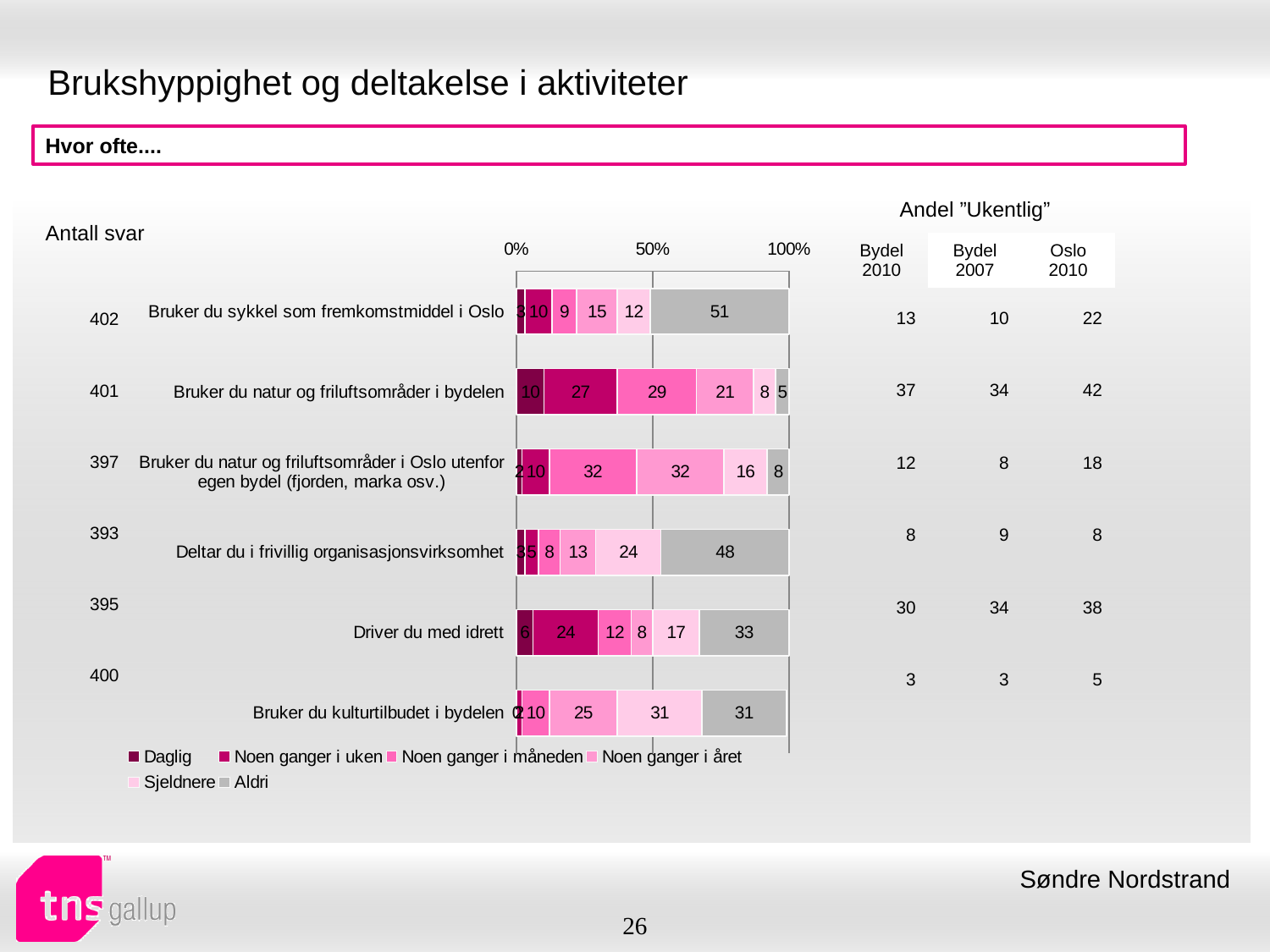
What is the value of the "Noen ganger i uken" segment for "Bruker du natur og friluftsområder i bydelen"? 27 What is the value of the "Aldri" segment for "Bruker du sykkel som fremkomstmiddel i Oslo"? 51 What is the value of the "Sjeldnere" segment for "Deltar du i frivillig organisasjonsvirksomhet"? 24 Which category has the largest "Aldri" segment? Bruker du sykkel som fremkomstmiddel i Oslo What is the value of the "Aldri" segment for "Deltar du i frivillig organisasjonsvirksomhet"? 48 What is the difference between the "Aldri" values for "Bruker du sykkel som fremkomstmiddel i Oslo" and "Driver du med idrett"? 18 How many categories (questions) are plotted in the chart? 6 How many series does the legend list? 6 Which category has the smallest "Aldri" segment? Bruker du natur og friluftsområder i bydelen Which is larger: the "Noen ganger i uken" value for "Driver du med idrett" or for "Bruker du sykkel som fremkomstmiddel i Oslo"? Driver du med idrett What type of chart is shown on the slide? Stacked bar chart What is the value of the "Aldri" segment for "Driver du med idrett"? 33